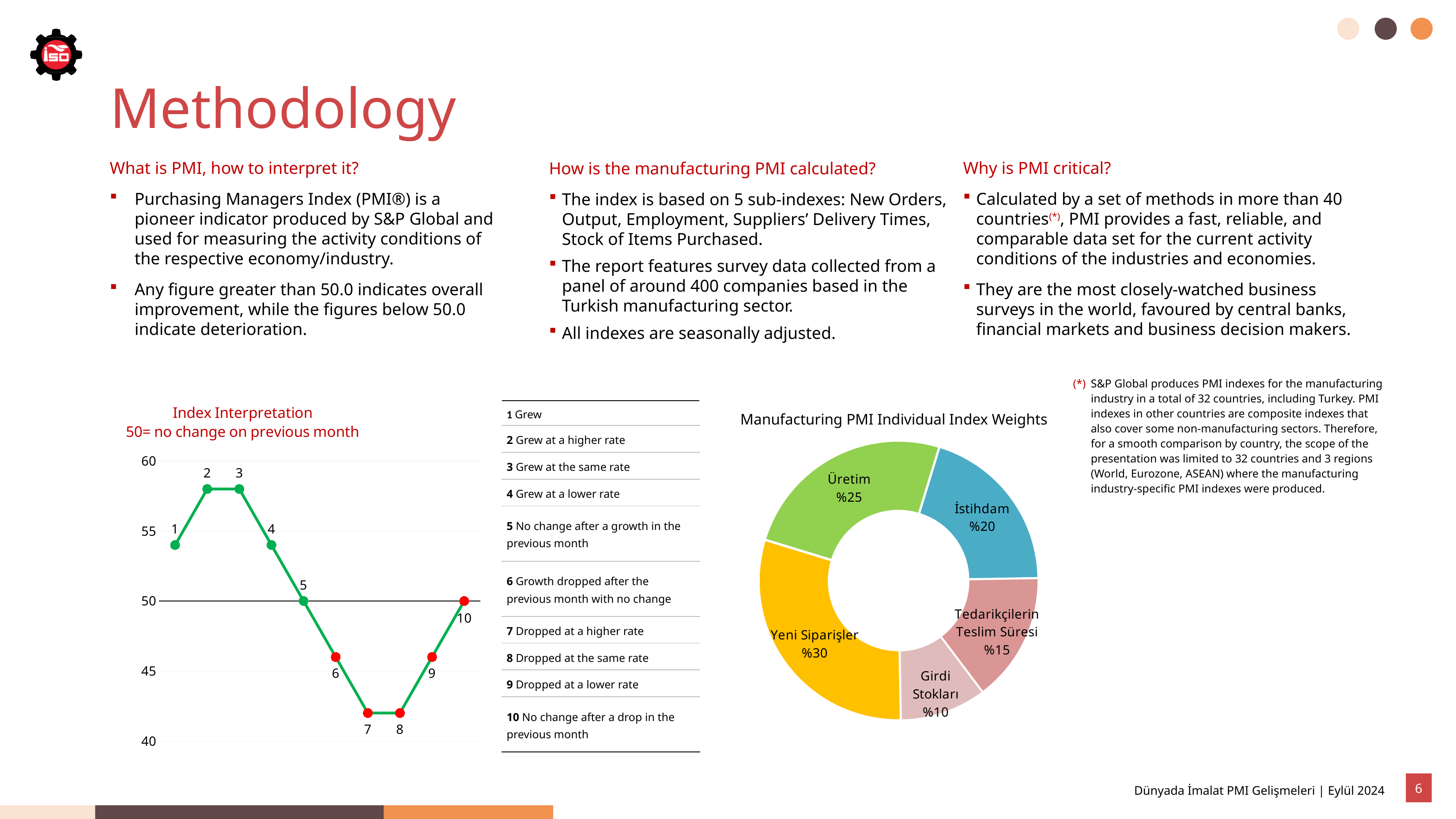
In the Manufacturing PMI Individual Index Weights chart, what is the weight of Girdi Stokları? %10 In the Manufacturing PMI Individual Index Weights chart, which has a larger weight, Üretim or İstihdam? Üretim How many components are shown in the Manufacturing PMI Individual Index Weights chart? 5 What kind of chart is the Index Interpretation chart? Line chart In the Manufacturing PMI Individual Index Weights chart, what is the weight of Üretim? %25 In the Manufacturing PMI Individual Index Weights chart, which component has the largest weight? Yeni Siparişler In the Manufacturing PMI Individual Index Weights chart, what is the difference between the weights of İstihdam and Tedarikçilerin Teslim Süresi? %5 In the Index Interpretation chart, is the value at point 2 greater or less than 55? greater In the Manufacturing PMI Individual Index Weights chart, what is the weight of Yeni Siparişler? %30 What kind of chart is the Manufacturing PMI Individual Index Weights chart? Doughnut chart In the Manufacturing PMI Individual Index Weights chart, which component has the smallest weight? Girdi Stokları In the Index Interpretation chart, is the value at point 7 greater or less than 45? less